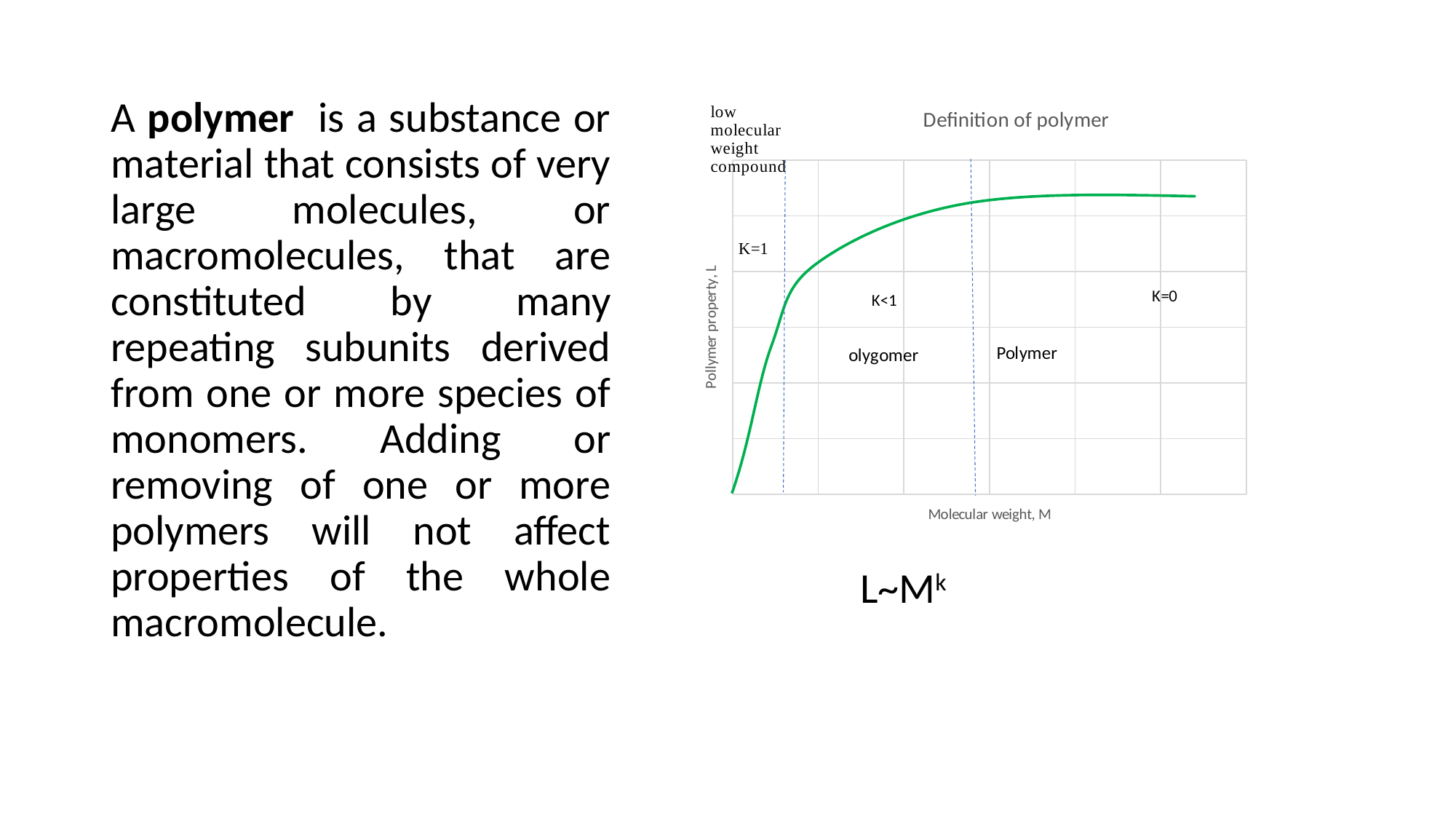
What is the label of the x axis of the chart? Molecular weight, M What kind of chart is shown on the slide? line chart Does the plotted line rise or fall as molecular weight increases along the x axis? rise Does the plotted line level off or keep rising steeply at the right-hand end of the chart? level off How many lines are plotted on the chart? 1 In which region of the chart, left or right, does the line rise most steeply? left What is the title of the chart? Definition of polymer